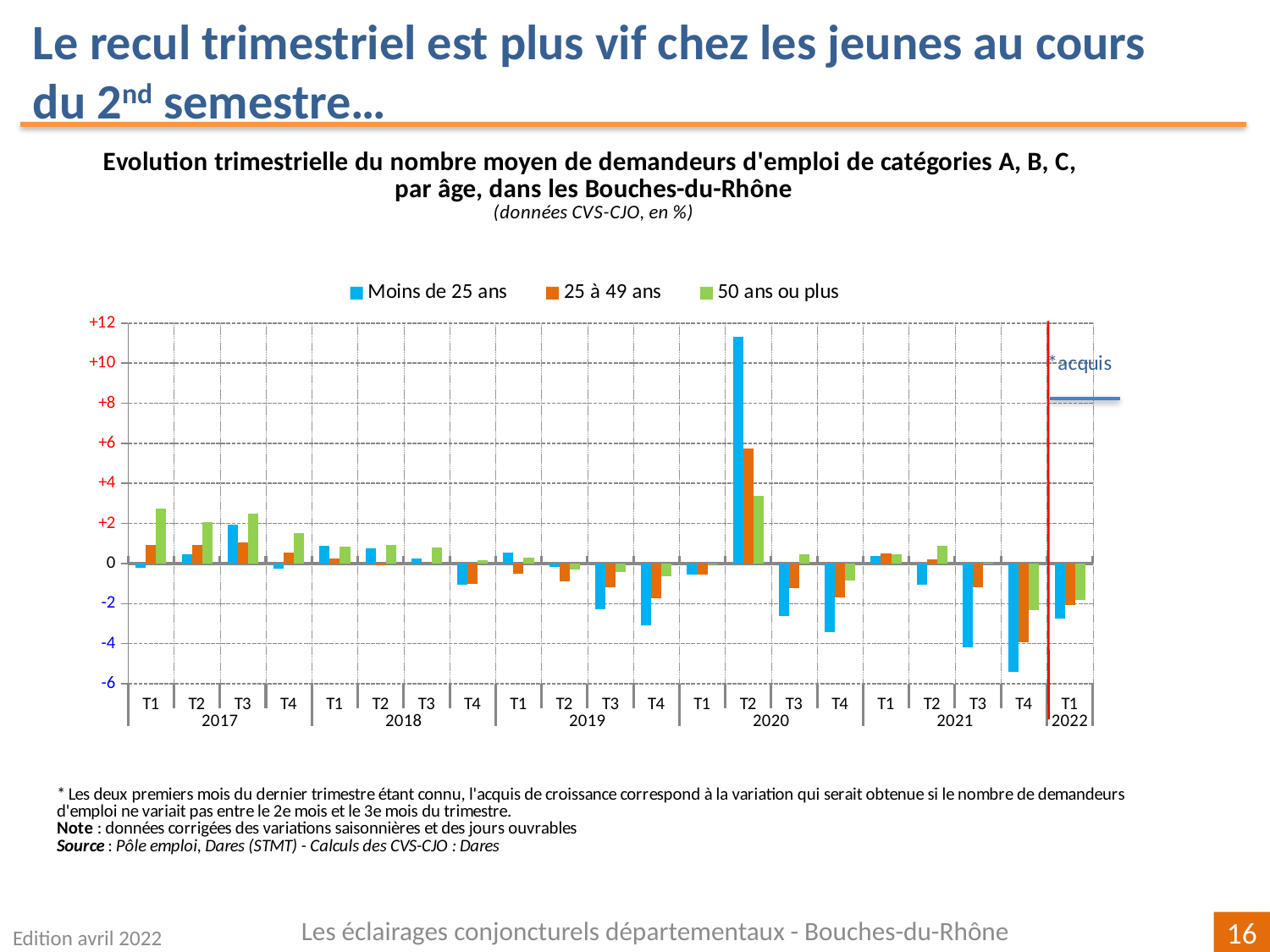
Is the value for '25 à 49 ans' in T2 2020 greater or less than +4? greater In which quarter is the value for 'Moins de 25 ans' the highest? T2 2020 In T1 2022, which series has the lower value: 'Moins de 25 ans' or '25 à 49 ans'? Moins de 25 ans In T2 2020, which series has the larger value: 'Moins de 25 ans' or '50 ans ou plus'? Moins de 25 ans What kind of chart is shown on the slide? bar chart How many series does the legend list? 3 Is the value for 'Moins de 25 ans' in T4 2021 greater or less than -4? less In which quarter is the value for 'Moins de 25 ans' the lowest? T4 2021 How many quarters are plotted along the x axis? 21 Is the value for 'Moins de 25 ans' in T2 2020 greater or less than +10? greater Which series is shown in blue in the legend? Moins de 25 ans